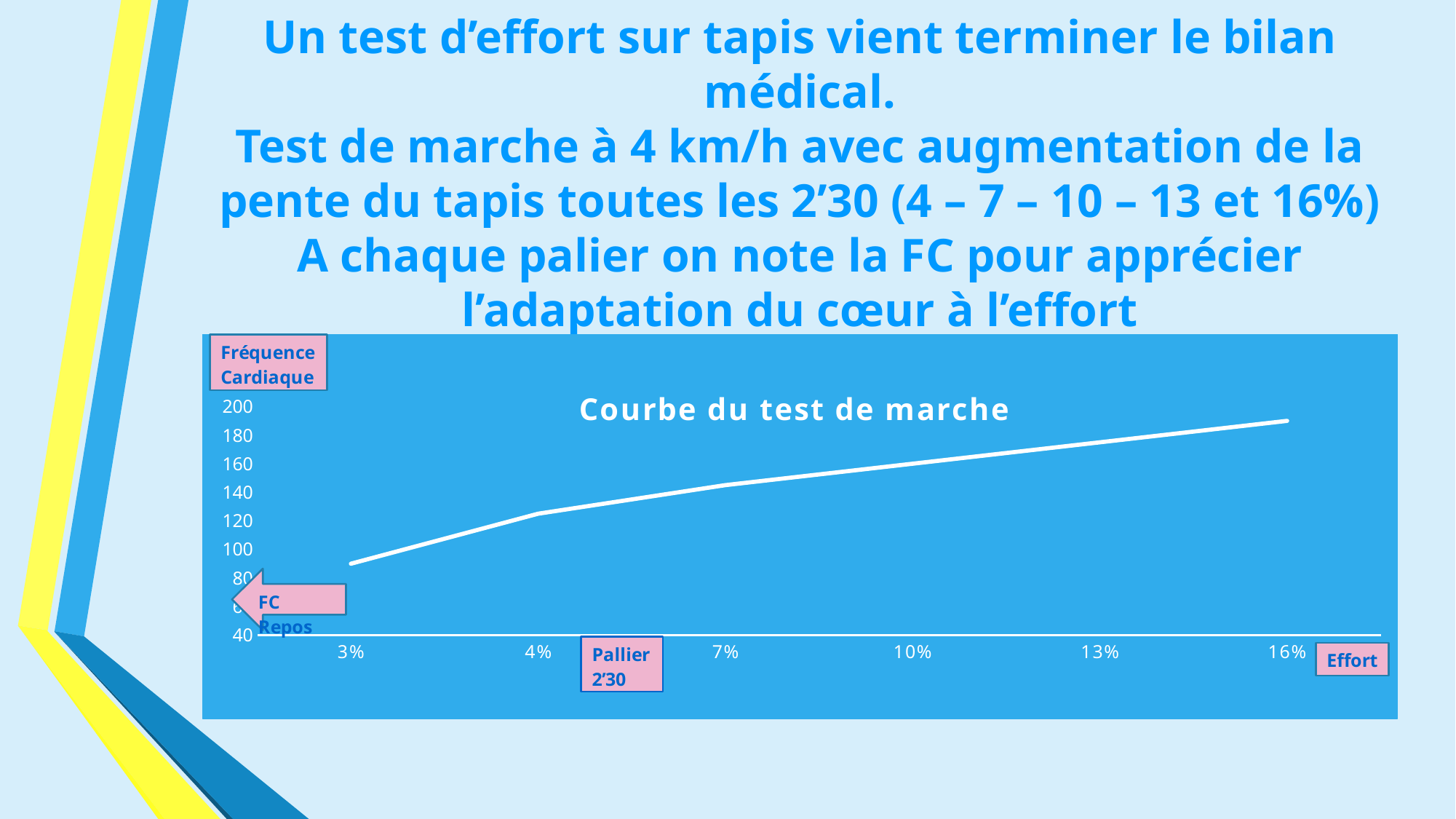
At which effort level is the heart rate lowest? 3% What is the highest value shown on the y axis of the chart? 200 What is the title of the chart? Courbe du test de marche Do the values rise or fall as the effort increases from 3% to 16%? rise What kind of chart is shown on the slide? line chart Is the value at 10% greater or less than 140? greater How many points are plotted along the x axis of the chart? 6 Is the value at 16% greater or less than 180? greater At which effort level is the heart rate highest? 16% Is the value at 13% greater or less than 160? greater Which has the larger heart rate value, 4% or 13%? 13%